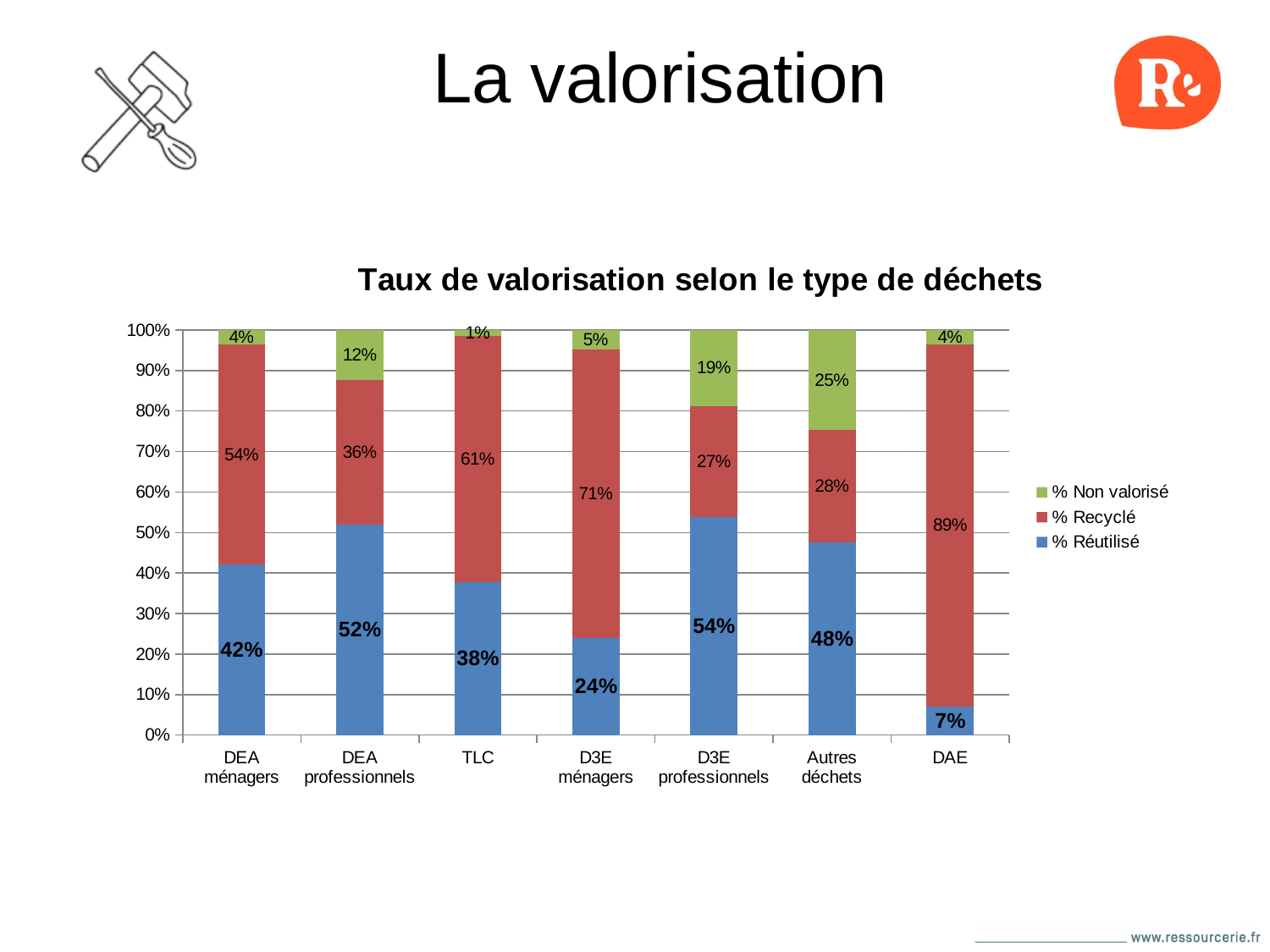
Which colour represents % Recyclé in the chart? Red Which is larger, the % Réutilisé value for DEA ménagers or for TLC? DEA ménagers What kind of chart is shown on the slide? Stacked bar chart How many waste categories are shown on the x axis? 7 What is the % Non valorisé value for Autres déchets? 25% Which category has the highest % Réutilisé value? D3E professionnels How many series does the legend list? 3 Which category has the lowest % Non valorisé value? TLC What is the title of the chart? Taux de valorisation selon le type de déchets What is the % Recyclé value for D3E ménagers? 71% What is the difference between the % Recyclé values for DAE and DEA professionnels? 53% What is the % Réutilisé value for DAE? 7%